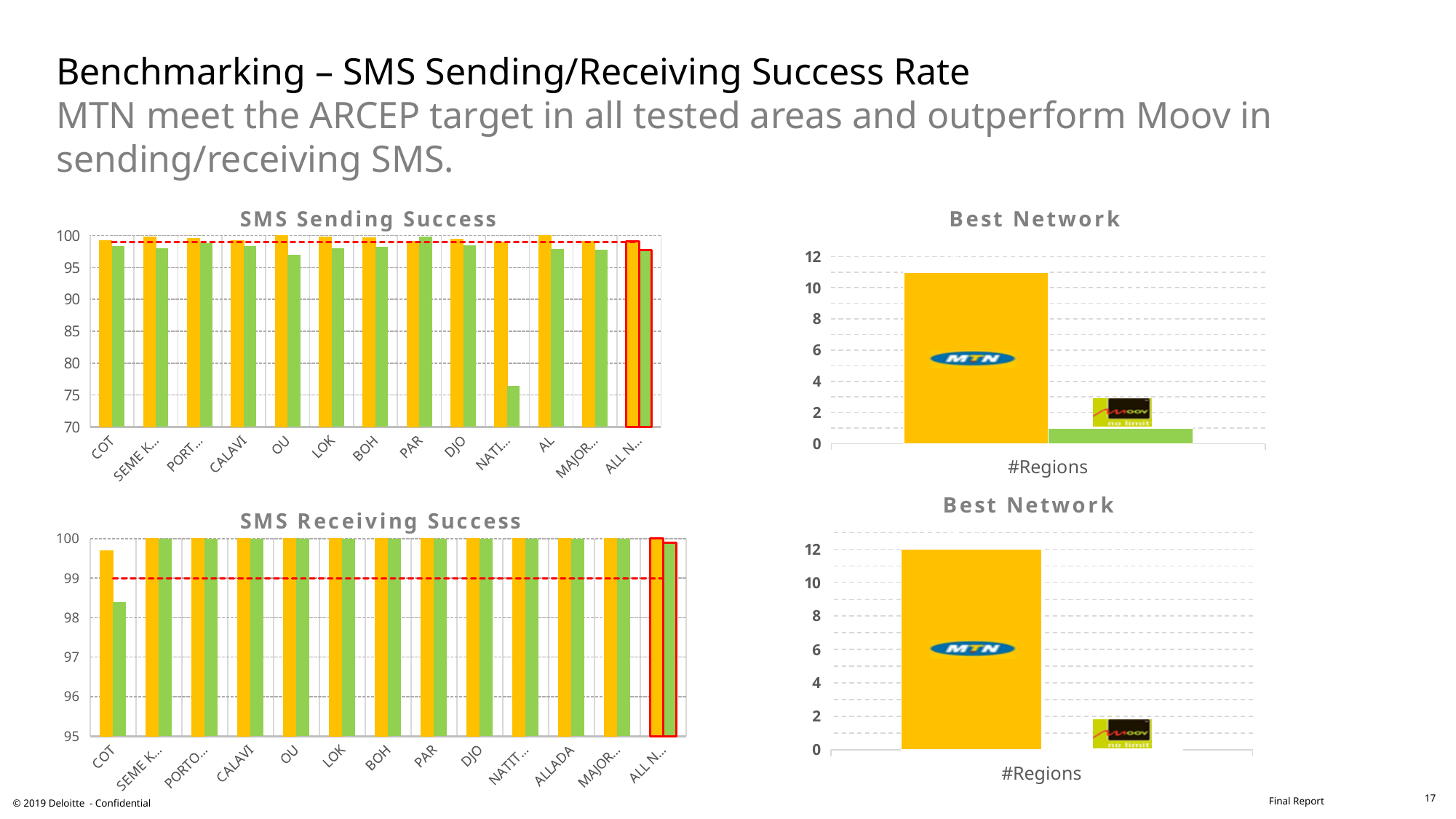
In the SMS Receiving Success chart, is the green bar for COT greater or less than 99? less In the SMS Receiving Success chart, is the orange bar for COT greater or less than 99? greater What is the x-axis label on the Best Network chart at the top right? #Regions How many categories are shown on the x axis of the SMS Receiving Success chart? 13 How many categories are shown on the x axis of the SMS Sending Success chart? 13 What kind of chart is the SMS Sending Success chart? bar chart In the Best Network chart at the bottom right, what is the value of the MTN bar? 12 In the Best Network chart at the top right, which network has the taller bar, MTN or Moov? MTN In the SMS Sending Success chart, is the green bar for NATI... greater or less than 80? less In the SMS Sending Success chart, which category has the lowest green bar? NATI... In the SMS Sending Success chart, for OU, which bar is taller, the orange bar or the green bar? the orange bar